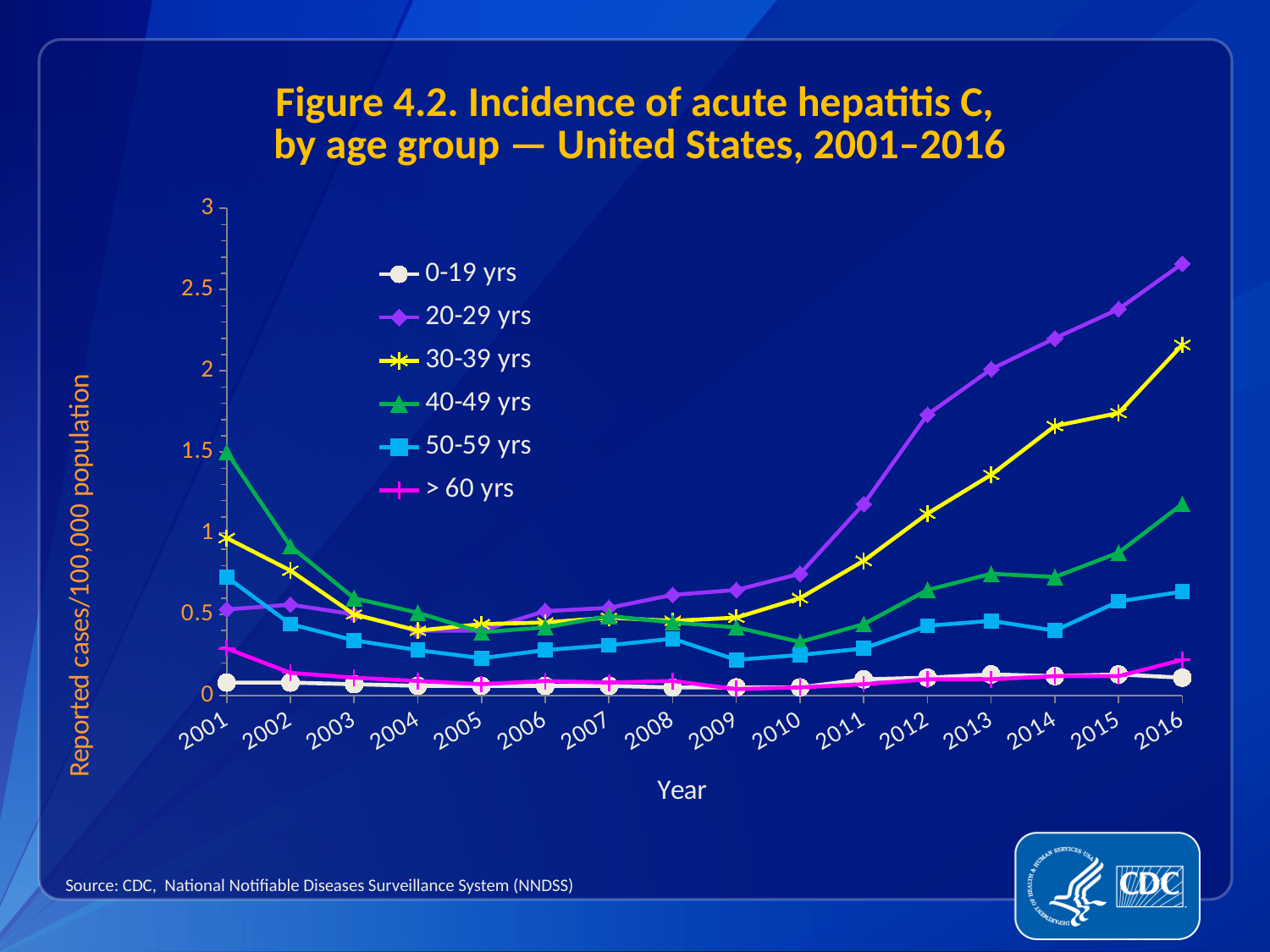
Is the value for 30-39 yrs in 2016 greater or less than 2? greater How many years are shown along the x axis? 16 Which age group has the highest incidence in 2001? 40-49 yrs Which age group has the highest incidence in 2016? 20-29 yrs What kind of chart is shown on the slide? line chart Does the incidence for 20-29 yrs rise or fall from 2010 to 2016? rise What is the label on the y axis? Reported cases/100,000 population Is the value for 20-29 yrs in 2016 greater or less than 2.5? greater How many age groups does the legend list? 6 Which age group has the lowest incidence in 2001? 0-19 yrs In 2016, which is larger: the value for 30-39 yrs or the value for 40-49 yrs? 30-39 yrs Is the value for > 60 yrs in 2016 greater or less than 0.5? less